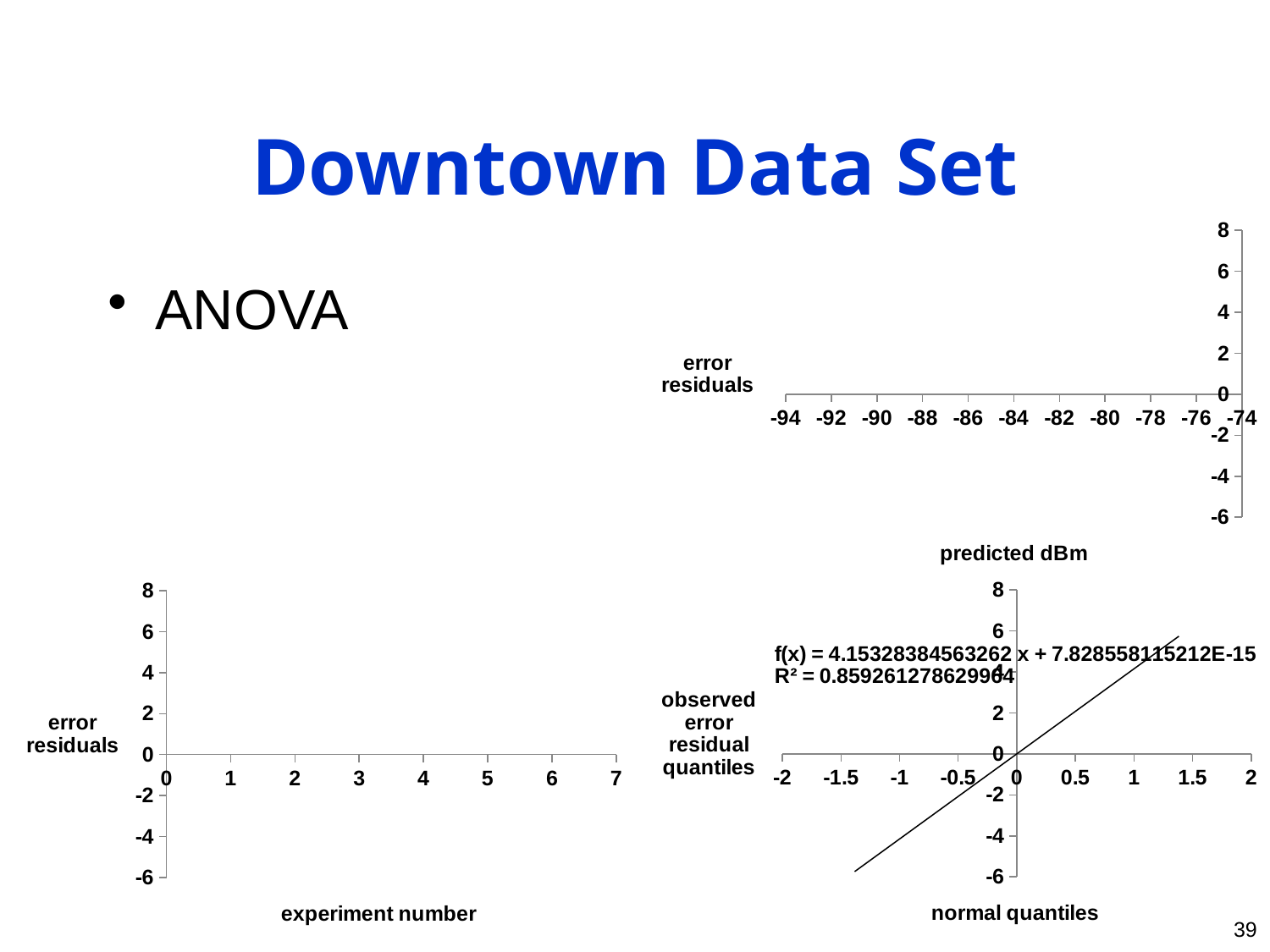
On the top-right chart (predicted dBm), what is the lowest value shown on the x axis? -94 On the top-right chart (predicted dBm), what is the highest value shown on the x axis? -74 On the bottom-right chart (normal quantiles), what is the lowest value shown on the x axis? -2 On the bottom-left chart (experiment number), what is the highest value shown on the y axis? 8 What is the x-axis label of the top-right chart? predicted dBm On the bottom-right chart (normal quantiles), does the fitted line rise or fall as the normal quantiles increase? rise What is the x-axis label of the bottom-left chart? experiment number How many charts are shown on the slide? 3 On the bottom-right chart (normal quantiles), what is the slope of the fitted line f(x) shown on the chart? 4.15328384563262 On the bottom-right chart (normal quantiles), what is the R² value printed on the chart? 0.859261278629964 On the bottom-right chart, is the R² value greater or less than 0.5? greater